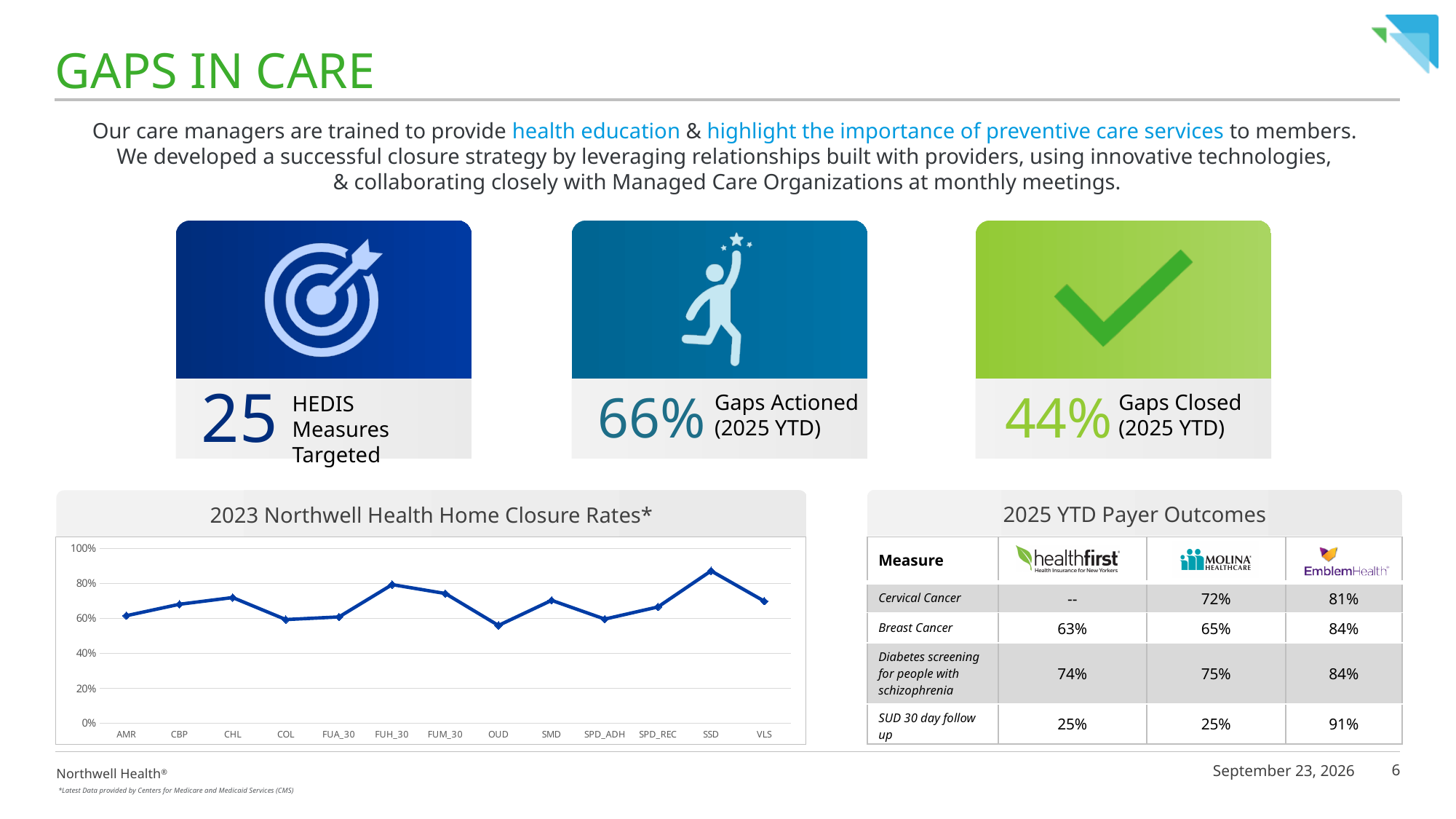
In the "2023 Northwell Health Home Closure Rates*" chart, which measure has the highest closure rate? SSD In the "2023 Northwell Health Home Closure Rates*" chart, is the value for CHL greater or less than 60%? greater In the "2023 Northwell Health Home Closure Rates*" chart, is the value for FUM_30 greater or less than 60%? greater In the "2023 Northwell Health Home Closure Rates*" chart, is the value for SSD greater or less than 80%? greater What is the title of the line chart on the slide? 2023 Northwell Health Home Closure Rates* In the "2023 Northwell Health Home Closure Rates*" chart, which has the higher closure rate, SSD or AMR? SSD In the "2023 Northwell Health Home Closure Rates*" chart, which has the higher closure rate, CHL or COL? CHL What type of chart is the "2023 Northwell Health Home Closure Rates*" chart? line chart In the "2023 Northwell Health Home Closure Rates*" chart, does the line rise or fall from SSD to VLS? fall How many measures are plotted along the x axis of the "2023 Northwell Health Home Closure Rates*" chart? 13 In the "2023 Northwell Health Home Closure Rates*" chart, which has the higher closure rate, FUH_30 or OUD? FUH_30